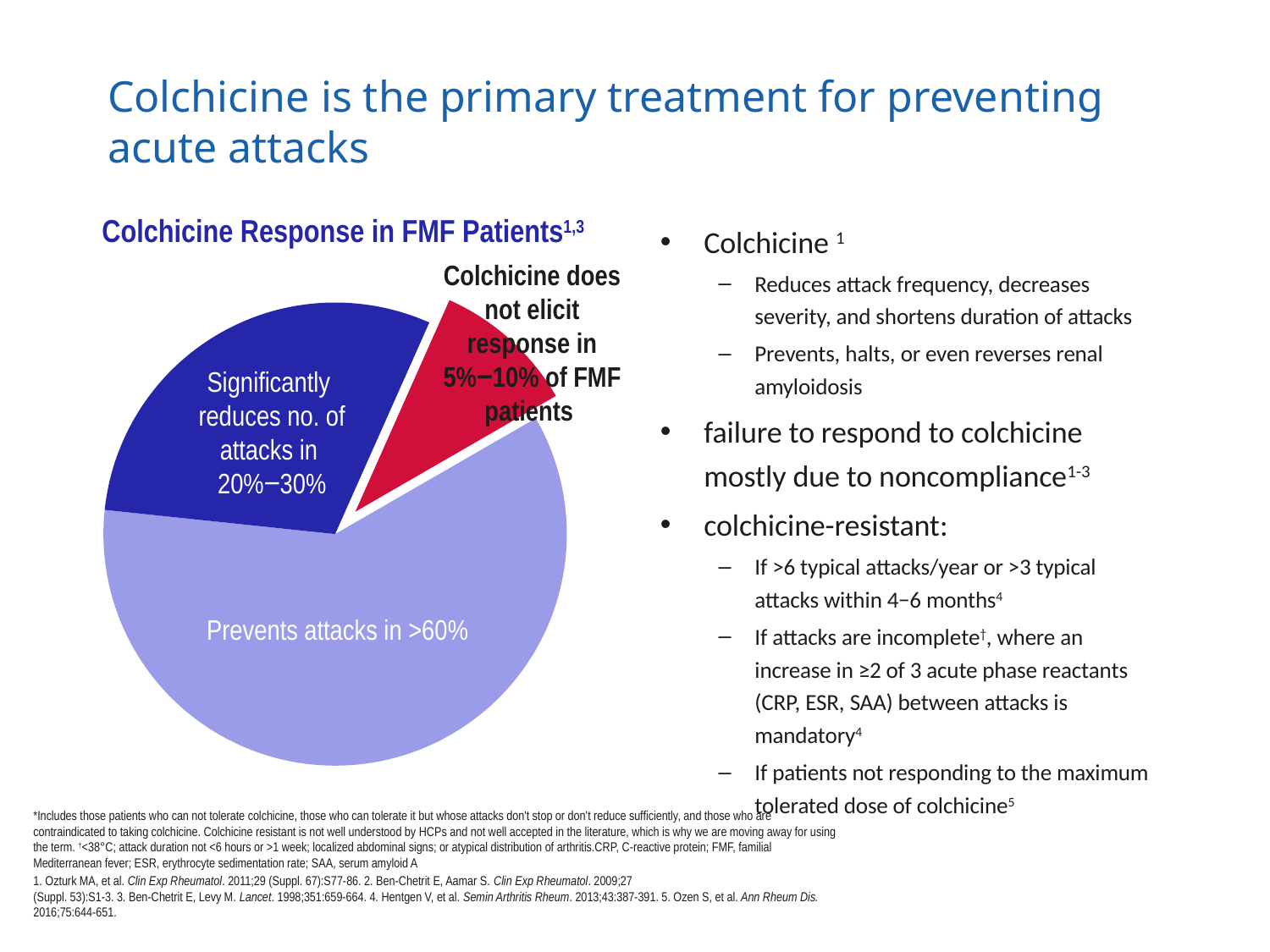
What is the title of the pie chart? Colchicine Response in FMF Patients What colour is the slice for patients in whom colchicine does not elicit a response? Red Which slice is larger: 'Prevents attacks' or 'Significantly reduces no. of attacks'? Prevents attacks According to the pie chart, in what percentage of patients does colchicine prevent attacks? >60% Which slice of the pie chart is the largest? Prevents attacks in >60% What kind of chart is shown on the slide? Pie chart According to the pie chart, in what percentage of FMF patients does colchicine not elicit a response? 5%−10% Which slice of the pie chart is the smallest? Colchicine does not elicit response in 5%−10% of FMF patients According to the pie chart, in what percentage of patients does colchicine significantly reduce the number of attacks? 20%−30% How many slices does the pie chart have? 3 Which slice is larger: 'Significantly reduces no. of attacks' or 'Colchicine does not elicit response'? Significantly reduces no. of attacks